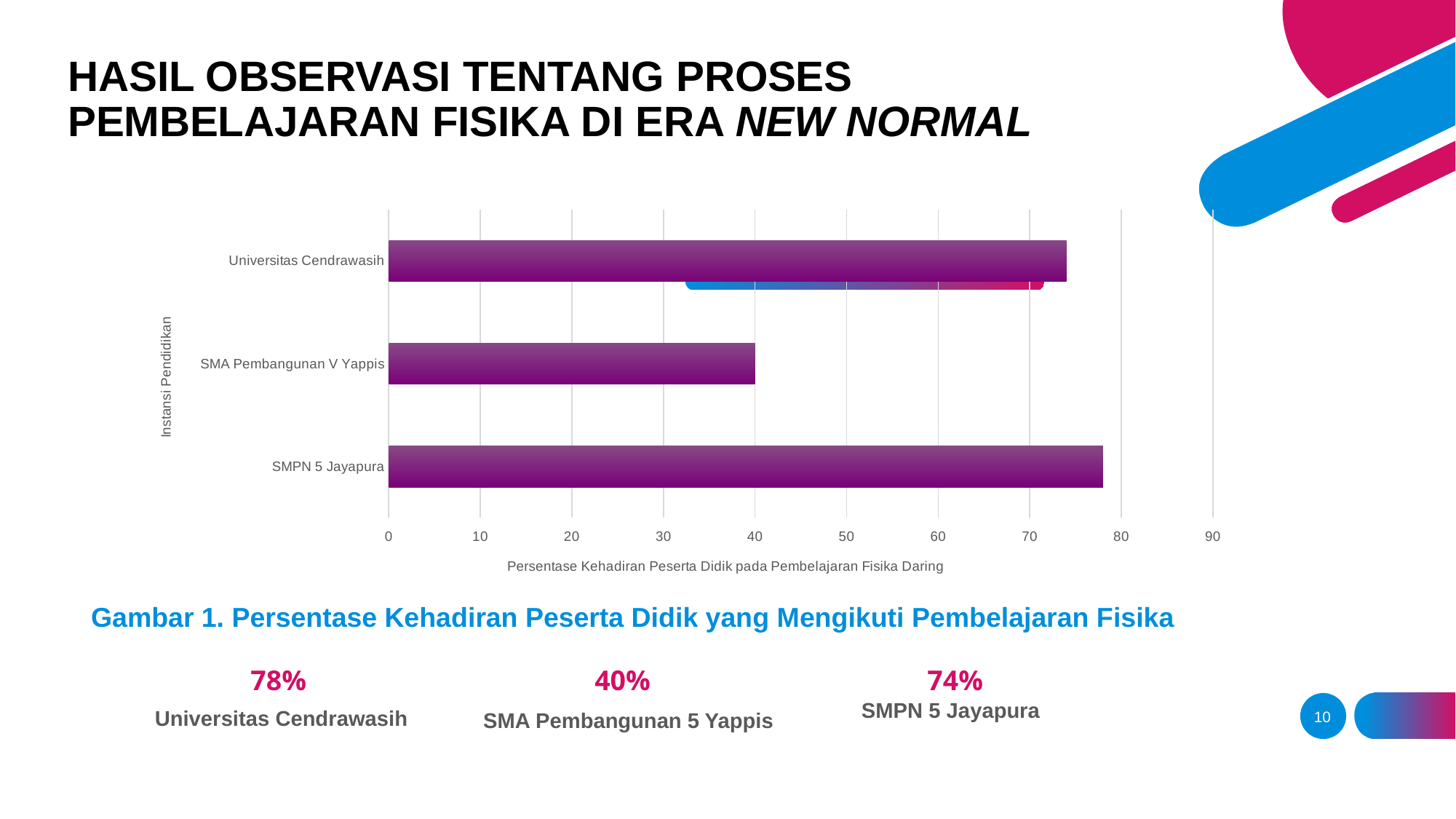
Which is larger, the value for SMPN 5 Jayapura or the value for SMA Pembangunan V Yappis? SMPN 5 Jayapura How many educational institutions (categories) are plotted in the chart? 3 What is the title of the vertical (y) axis of the chart? Instansi Pendidikan Is the value for SMA Pembangunan V Yappis greater or less than 50? less What kind of chart is shown on the slide? bar chart What is the title of the horizontal (x) axis of the chart? Persentase Kehadiran Peserta Didik pada Pembelajaran Fisika Daring Which institution has the lowest attendance percentage in the chart? SMA Pembangunan V Yappis Which is larger, the value for Universitas Cendrawasih or the value for SMA Pembangunan V Yappis? Universitas Cendrawasih Is the value for SMPN 5 Jayapura greater or less than 70? greater What is the attendance percentage for SMA Pembangunan V Yappis? 40% Is the value for Universitas Cendrawasih greater or less than 70? greater